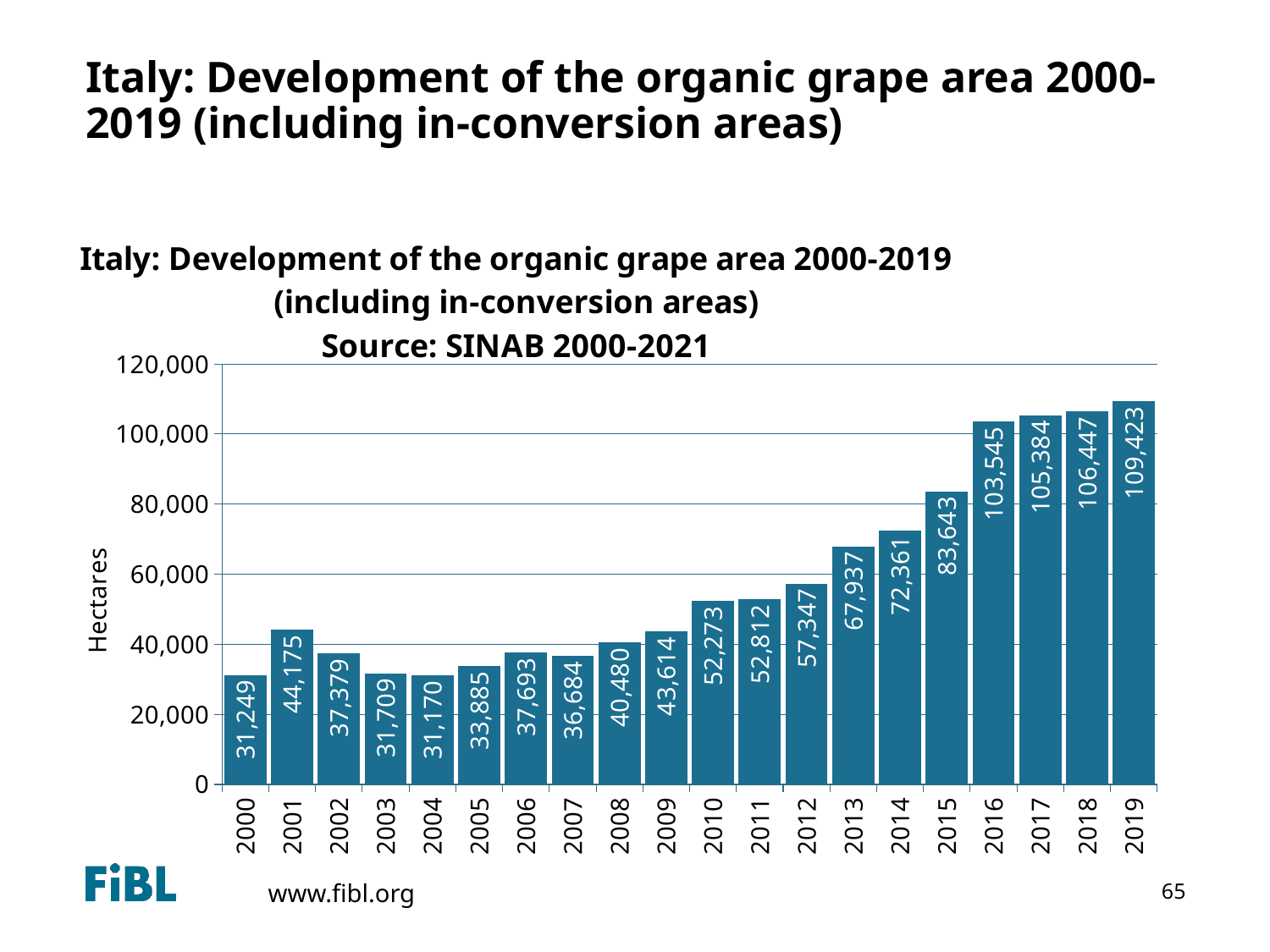
Which year had a larger organic grape area, 2001 or 2002? 2001 Which year has the lowest organic grape area? 2004 What kind of chart is shown on the slide? Bar chart Is the value for 2013 greater or less than 60,000? greater What was the organic grape area in Italy in 2015? 83,643 What is the difference in organic grape area between 2019 and 2018? 2,976 How many years are shown on the x axis? 20 What was the organic grape area in Italy in 2009? 43,614 Which year has the highest organic grape area? 2019 What is the difference in organic grape area between 2001 and 2000? 12,926 What was the organic grape area in Italy in 2000? 31,249 What is the label of the y axis? Hectares